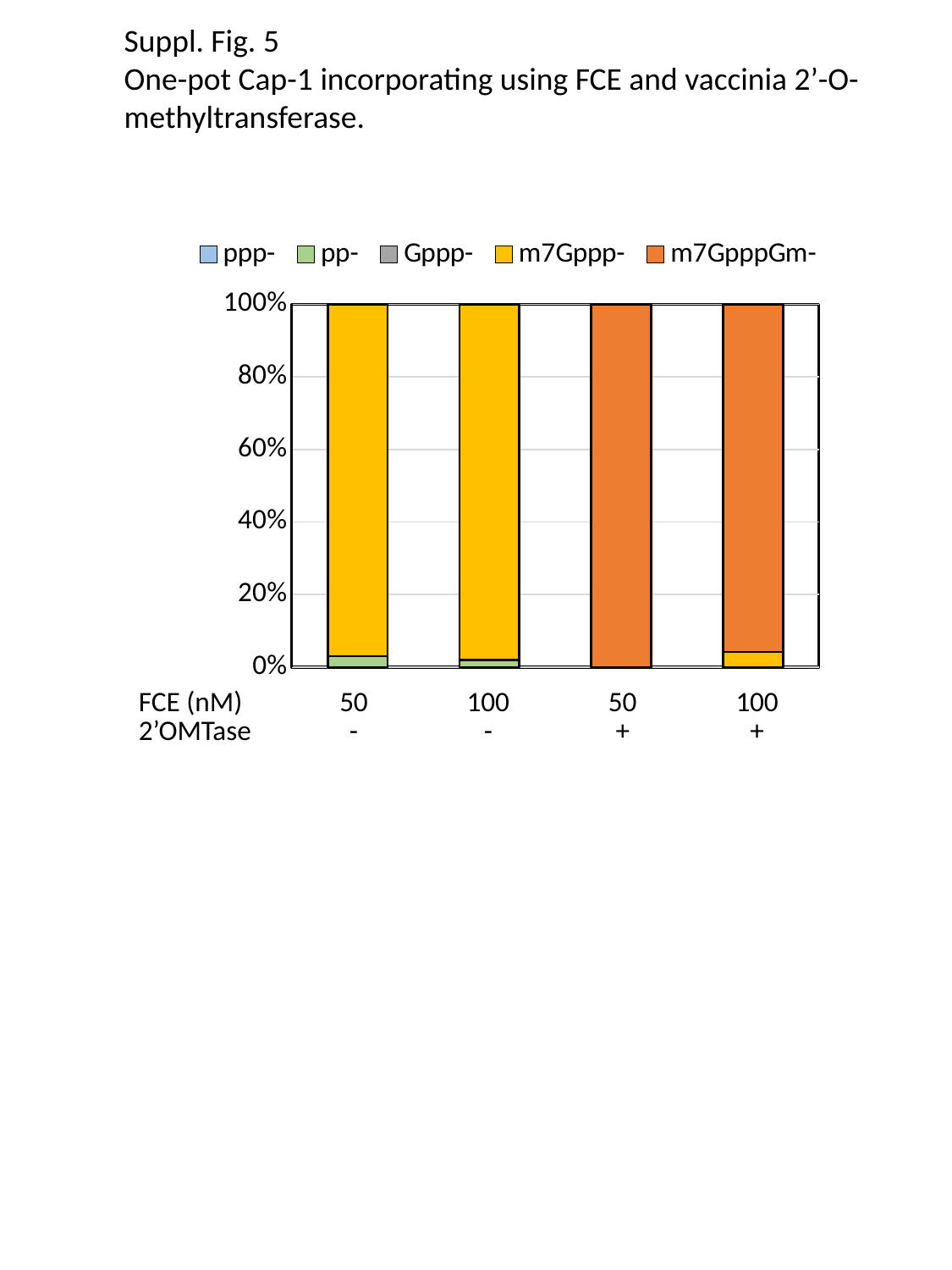
Which legend entry is shown in orange? m7GpppGm- How many series does the legend list? 5 What is the total height of the stacked bar for FCE 100 nM with 2'OMTase -? 100% Is the value for pp- in the FCE 50 nM, 2'OMTase - bar greater or less than 20%? less Is the value for m7Gppp- in the FCE 50 nM, 2'OMTase - bar greater or less than 80%? greater Which series makes up almost all of the bar for FCE 50 nM with 2'OMTase +? m7GpppGm- What are the two row labels under the x axis of the chart? FCE (nM) and 2'OMTase Is the value for m7Gppp- in the FCE 100 nM, 2'OMTase + bar greater or less than 20%? less How many bars are plotted in the chart? 4 Which series makes up almost all of the bar for FCE 50 nM with 2'OMTase -? m7Gppp- What kind of chart is shown on the slide? stacked bar chart